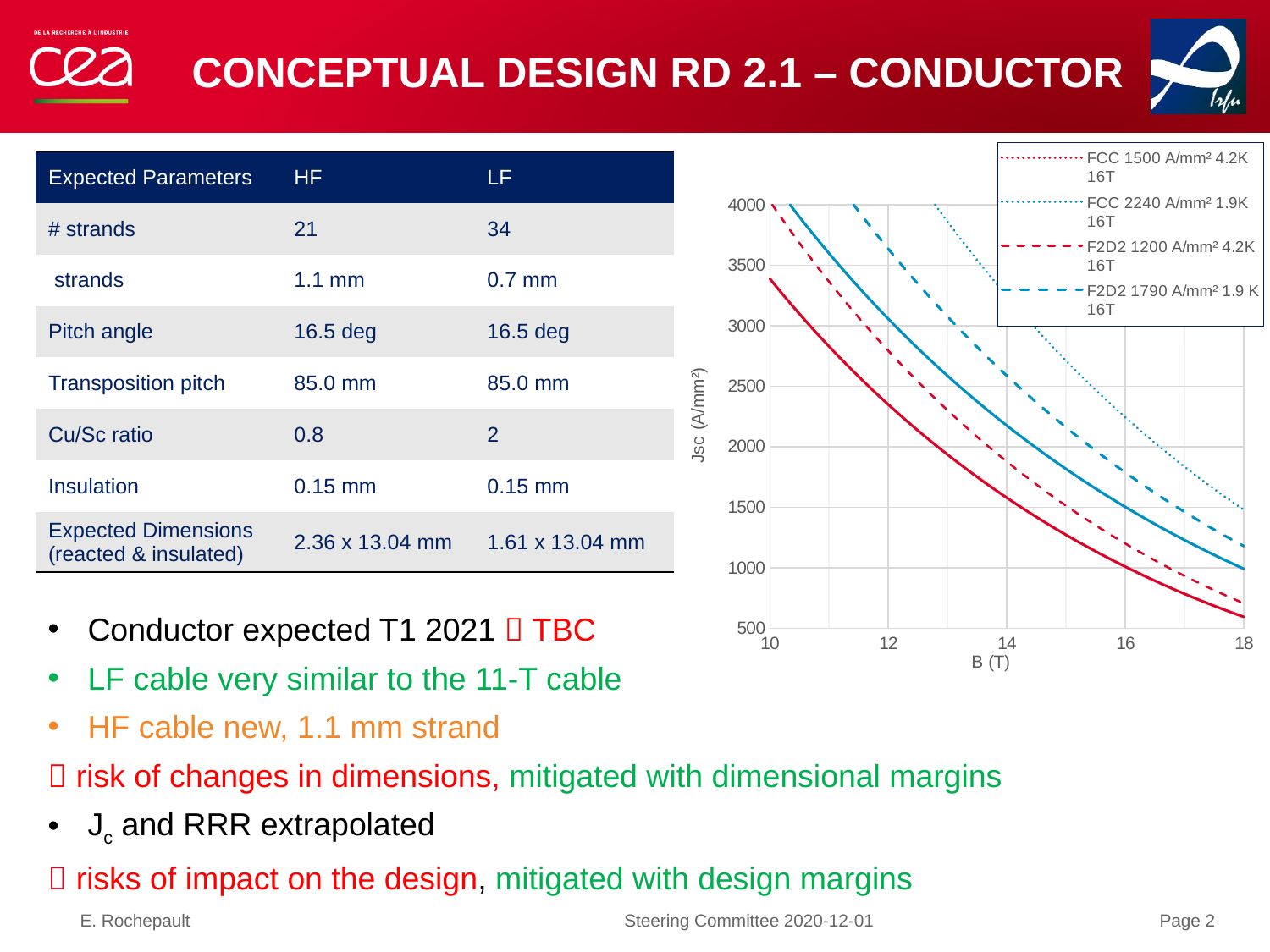
At B = 18 T, is the value of the F2D2 1790 A/mm² 1.9 K 16T curve greater or less than 1000? greater How many series does the legend of the Jsc vs B chart list? 4 At B = 14 T, is the value of the F2D2 1200 A/mm² 4.2K 16T curve greater or less than 2000? less Of the four series listed in the legend, which has the lowest Jsc at B = 18 T? F2D2 1200 A/mm² 4.2K 16T At B = 18 T, is the value of the F2D2 1200 A/mm² 4.2K 16T curve greater or less than 1000? less Of the four series listed in the legend, which has the highest Jsc at B = 18 T? FCC 2240 A/mm² 1.9K 16T Do the curves in the Jsc vs B chart rise or fall as B increases? fall What is the label of the y axis of the chart? Jsc (A/mm²) At B = 18 T, which curve is higher: F2D2 1790 A/mm² 1.9 K 16T or F2D2 1200 A/mm² 4.2K 16T? F2D2 1790 A/mm² 1.9 K 16T What is the label of the x axis of the chart? B (T) What kind of chart is shown on the right of the slide? line chart